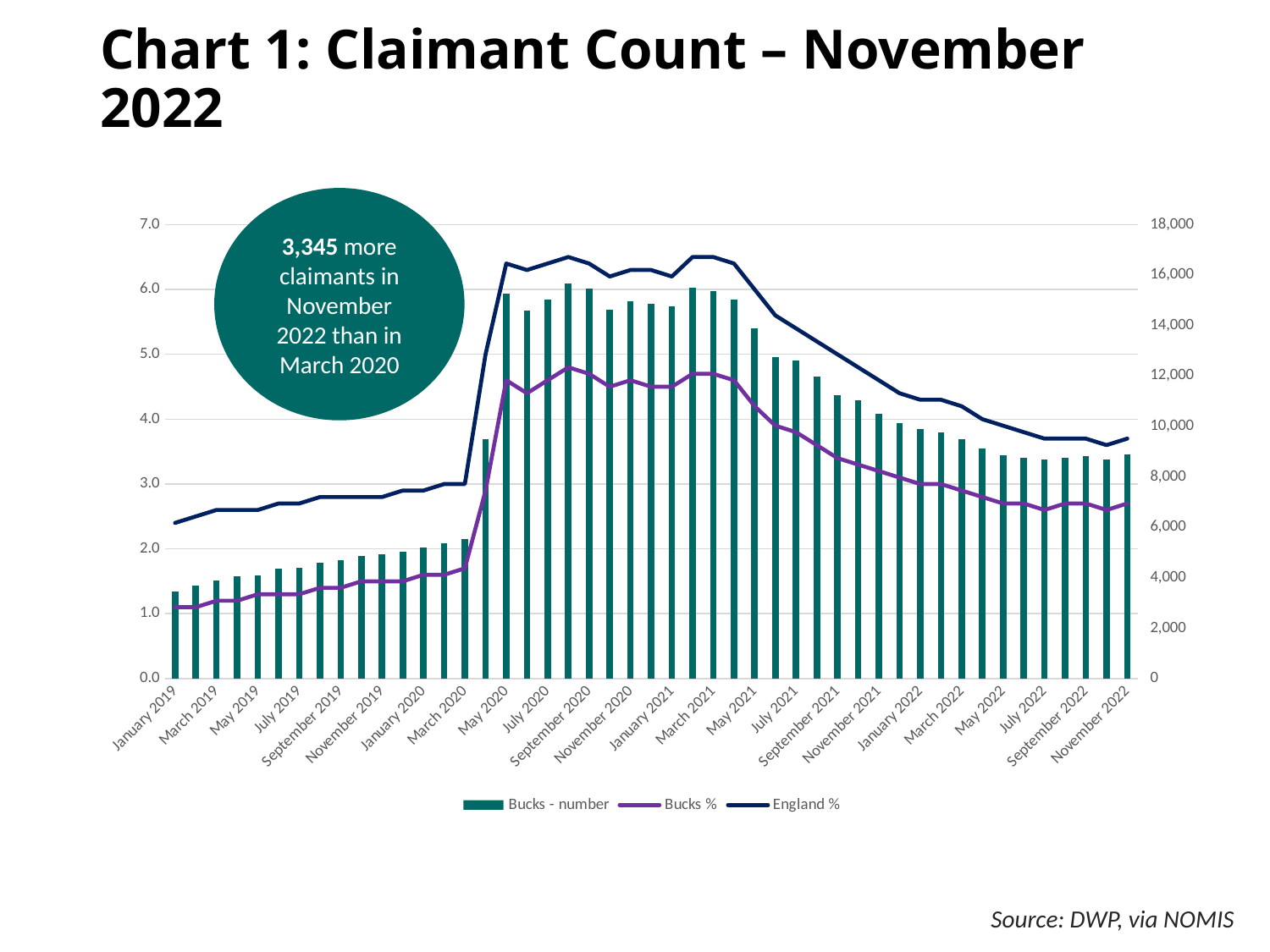
Is the value for Bucks - number in January 2019 greater or less than 4,000? less Does Bucks % rise or fall between March 2021 and November 2022? Fall According to the callout on the chart, how many more claimants were there in November 2022 than in March 2020? 3,345 What are the three series named in the legend? Bucks - number, Bucks %, England % Is the value for England % in March 2021 greater or less than 6.0? greater In November 2022, which is higher: England % or Bucks %? England % What kind of chart is shown on the slide? A combined bar and line chart Is the value for Bucks - number in November 2022 greater or less than 10,000? less Which month has the lowest value for Bucks - number? January 2019 How many series does the legend list? 3